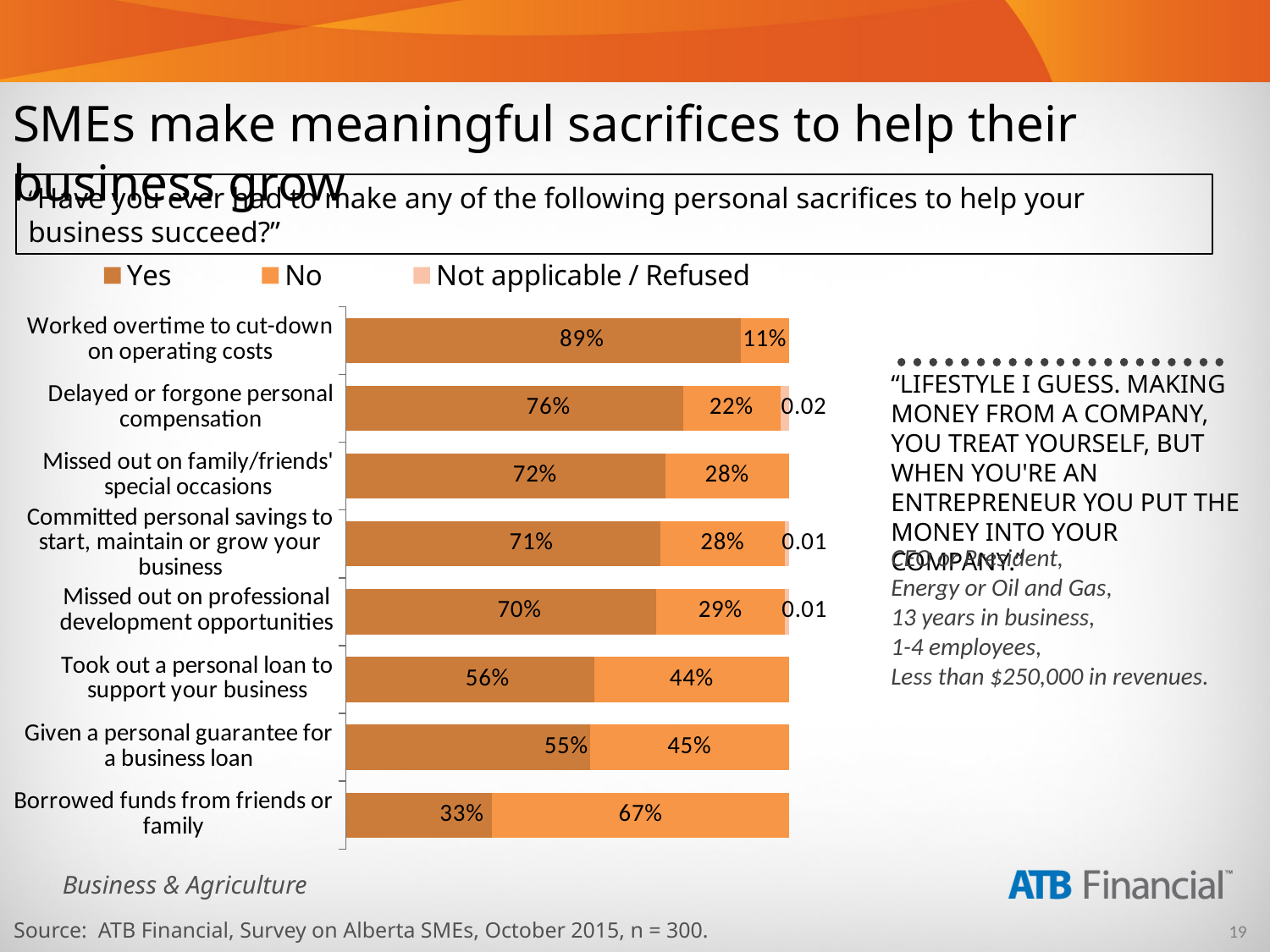
Which is larger: the Yes value for "Given a personal guarantee for a business loan" or the Yes value for "Missed out on family/friends' special occasions"? Missed out on family/friends' special occasions How many categories (sacrifices) are shown in the chart? 8 What is the No value for "Borrowed funds from friends or family"? 67% How many series does the legend list? 3 Which series is shown in the darkest colour in the legend? Yes What is the Not applicable / Refused value shown for "Missed out on professional development opportunities"? 0.01 What kind of chart is shown on the slide? Stacked bar chart What is the difference between the Yes and No values for "Delayed or forgone personal compensation"? 54% Which category has the lowest Yes percentage? Borrowed funds from friends or family Which category has the highest Yes percentage? Worked overtime to cut-down on operating costs What is the Yes value for "Took out a personal loan to support your business"? 56% What percentage of respondents answered Yes to "Worked overtime to cut-down on operating costs"? 89%